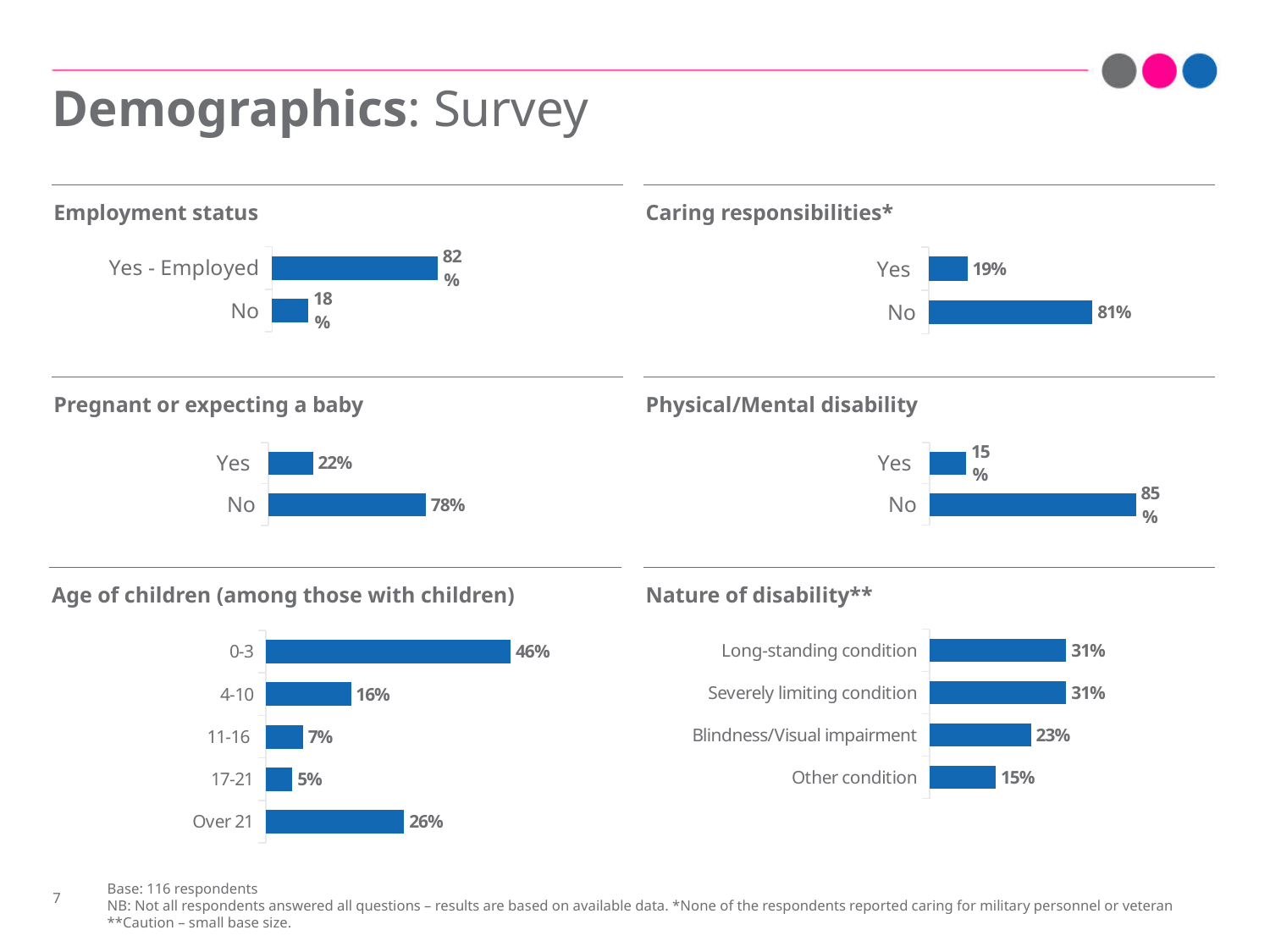
In the Pregnant or expecting a baby chart, what is the value for Yes? 22% In the Employment status chart, what percentage of respondents are employed? 82% In the Age of children chart, which age group has the highest value? 0-3 In the Age of children chart, which age group has the lowest value? 17-21 What type of chart is the Nature of disability chart? Bar chart In the Nature of disability chart, which condition has the lowest value? Other condition In the Caring responsibilities chart, what is the value for No? 81% In the Caring responsibilities chart, which is larger, Yes or No? No In the Age of children chart, what is the difference between the values for 0-3 and Over 21? 20% In the Nature of disability chart, what is the value for Blindness/Visual impairment? 23% How many categories are shown in the Age of children chart? 5 In the Physical/Mental disability chart, what is the value for Yes? 15%